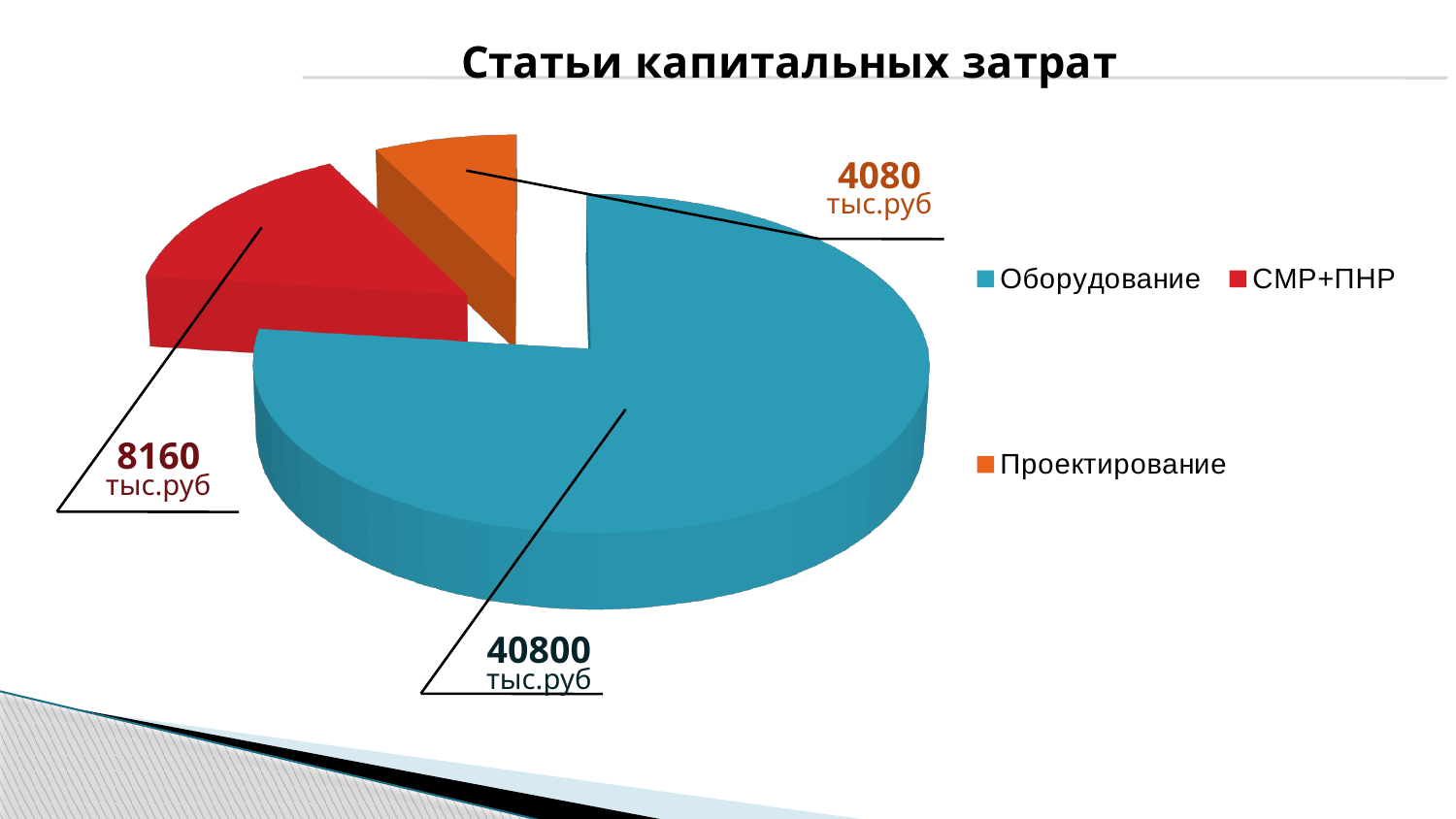
How many categories does the pie chart have? 3 What is the difference between the values for СМР+ПНР and Проектирование? 4080 тыс.руб What is the title of the chart? Статьи капитальных затрат What kind of chart is shown on the slide? pie chart What is the total of all three slices of the pie? 53040 тыс.руб Which is larger, the value for СМР+ПНР or the value for Проектирование? СМР+ПНР Which category has the smallest slice of the pie? Проектирование What is the value for Оборудование? 40800 тыс.руб What is the value for Проектирование? 4080 тыс.руб What is the value for СМР+ПНР? 8160 тыс.руб Which category has the largest slice of the pie? Оборудование What is the difference between the values for Оборудование and СМР+ПНР? 32640 тыс.руб